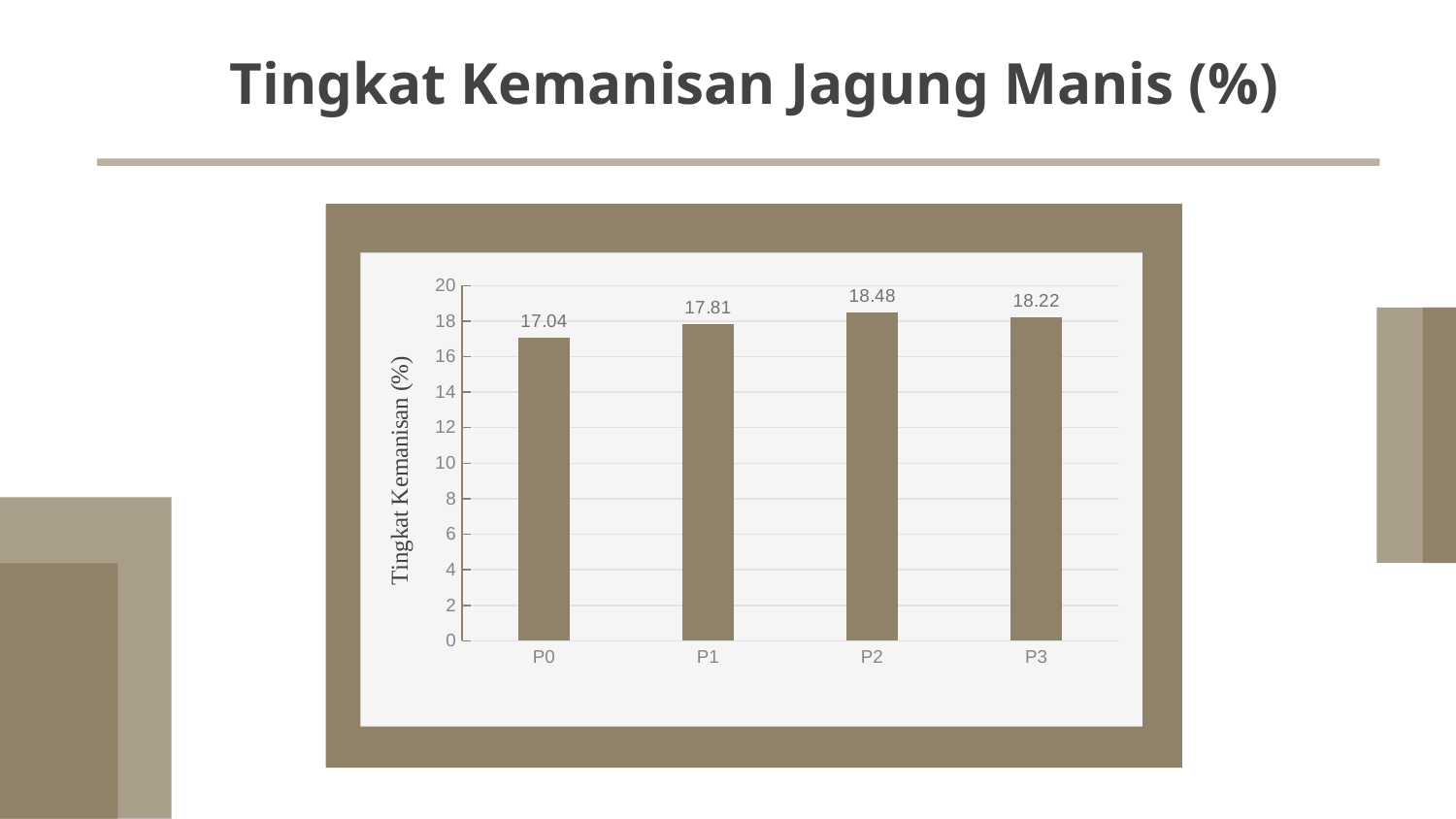
What is the value for P0? 17.04 What is the difference between the values for P1 and P0? 0.77 Which is larger, the value for P1 or the value for P3? P3 Which category has the lowest value? P0 How many categories are shown on the x axis? 4 What is the value for P3? 18.22 Is the value for P1 greater or less than 16? greater Which category has the highest value? P2 What kind of chart is shown on the slide? bar chart What is the value for P2? 18.48 What is the difference between the values for P2 and P0? 1.44 What is the label of the y axis? Tingkat Kemanisan (%)